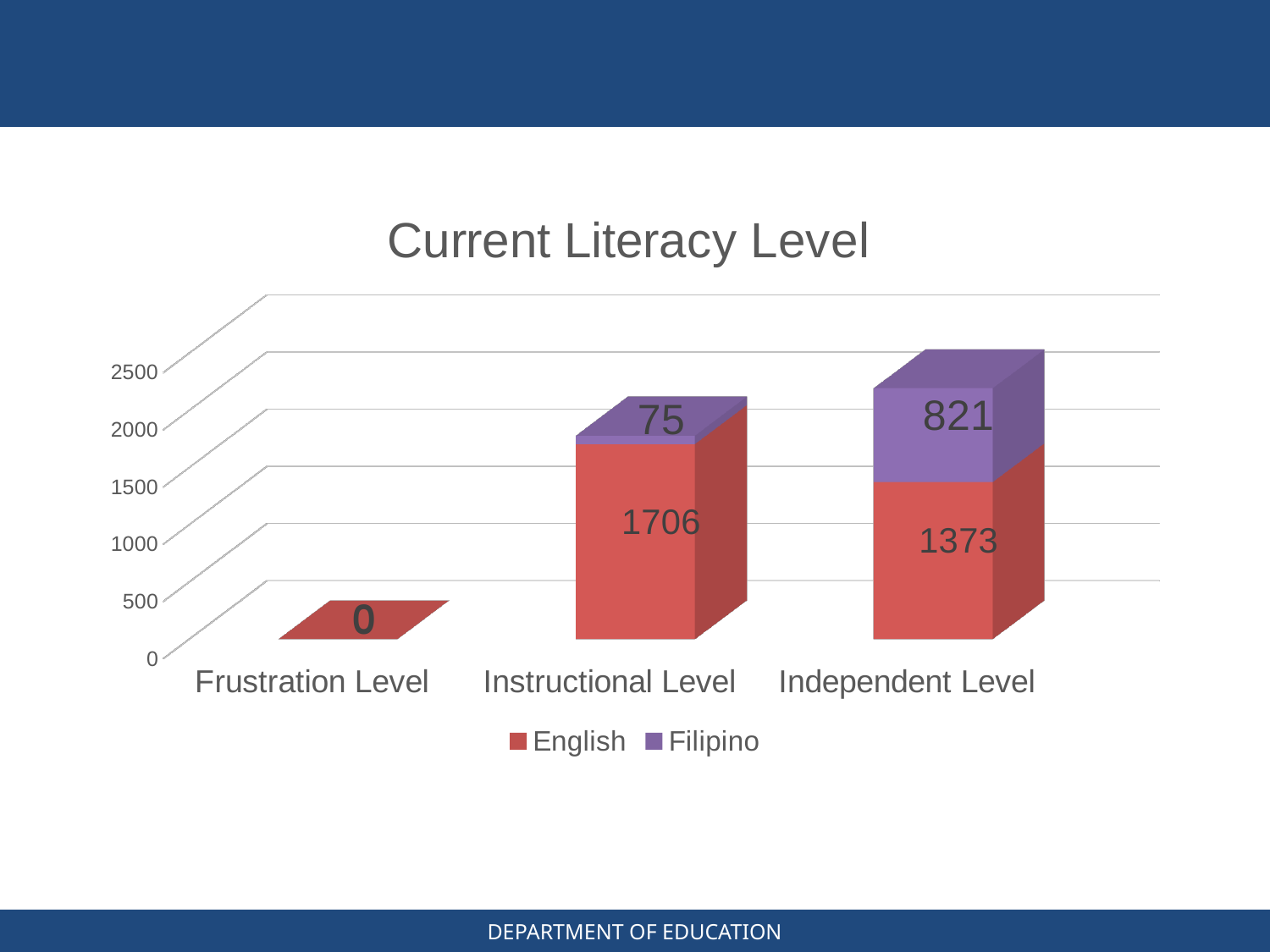
What is the total of the stacked bar for Independent Level? 2194 How many series does the legend list? 2 What is the Filipino value for Instructional Level? 75 Which category has the lowest English value? Frustration Level What is the English value for Frustration Level? 0 Which is larger, the Filipino value for Independent Level or the Filipino value for Instructional Level? Independent Level How many categories are shown on the x axis? 3 What is the English value for Instructional Level? 1706 What is the title of the chart? Current Literacy Level What is the difference between the English values for Instructional Level and Independent Level? 333 Which category has the highest English value? Instructional Level What is the Filipino value for Independent Level? 821